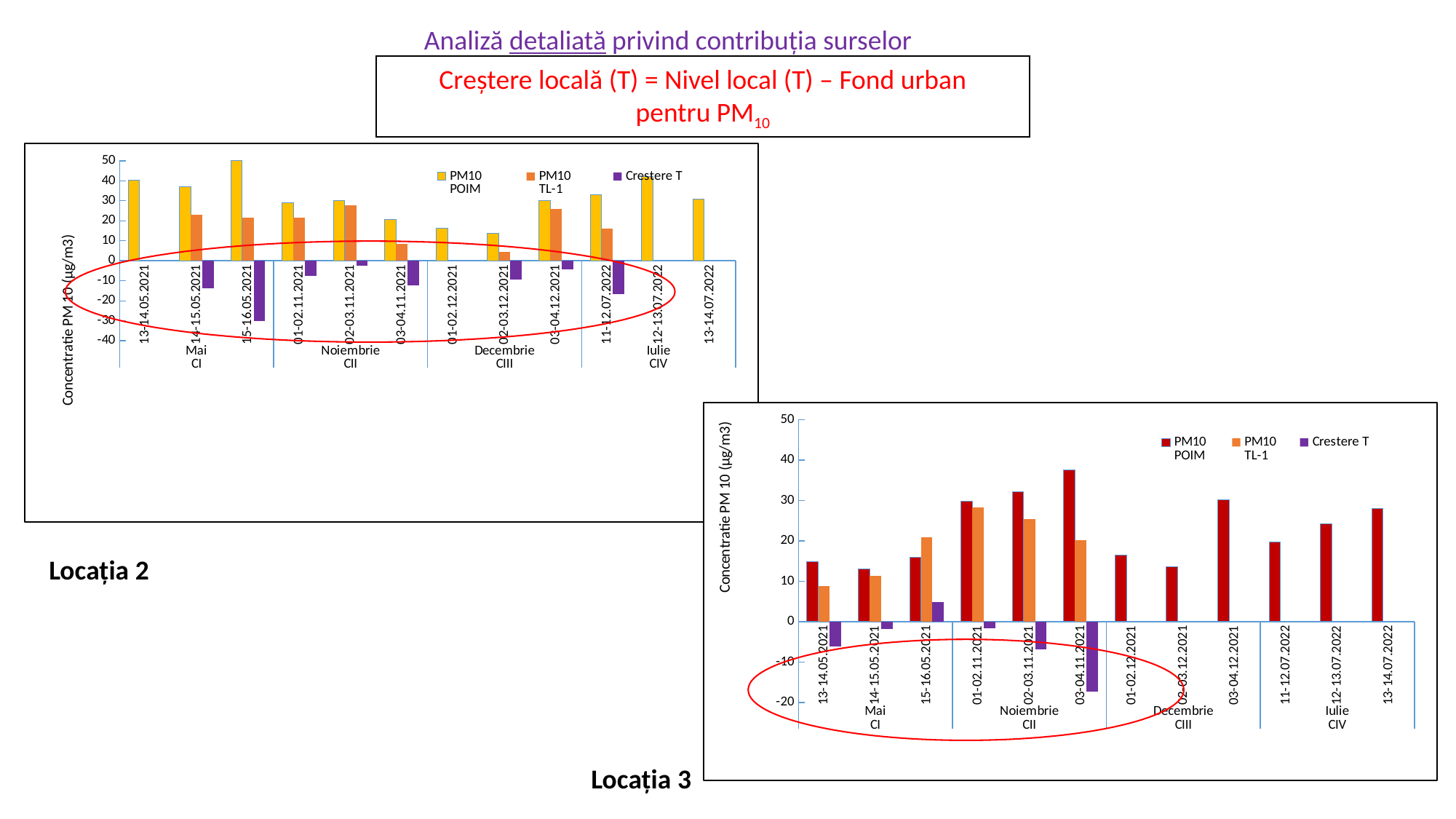
How many date categories are shown on the x axis of the Locația 2 chart? 12 In the Locația 3 chart, is the PM10 POIM value for 02-03.11.2021 greater or less than 30? greater In the Locația 2 chart, is the PM10 POIM value for 01-02.12.2021 greater or less than 20? less In the Locația 2 chart, is the PM10 POIM value for 15-16.05.2021 greater or less than 40? greater In the Locația 2 chart, which date has the highest PM10 POIM value? 15-16.05.2021 What kind of chart is the Locația 2 chart? bar chart In the Locația 3 chart, which date has the lowest Crestere T value? 03-04.11.2021 What is the y-axis label of the Locația 3 chart? Concentratie PM 10 (µg/m3) In the Locația 3 chart, for 15-16.05.2021, which is larger: PM10 POIM or PM10 TL-1? PM10 TL-1 In the Locația 2 chart, which date has the lowest Crestere T value? 15-16.05.2021 How many series does the legend of the Locația 3 chart list? 3 In the Locația 3 chart, which date has the highest PM10 POIM value? 03-04.11.2021